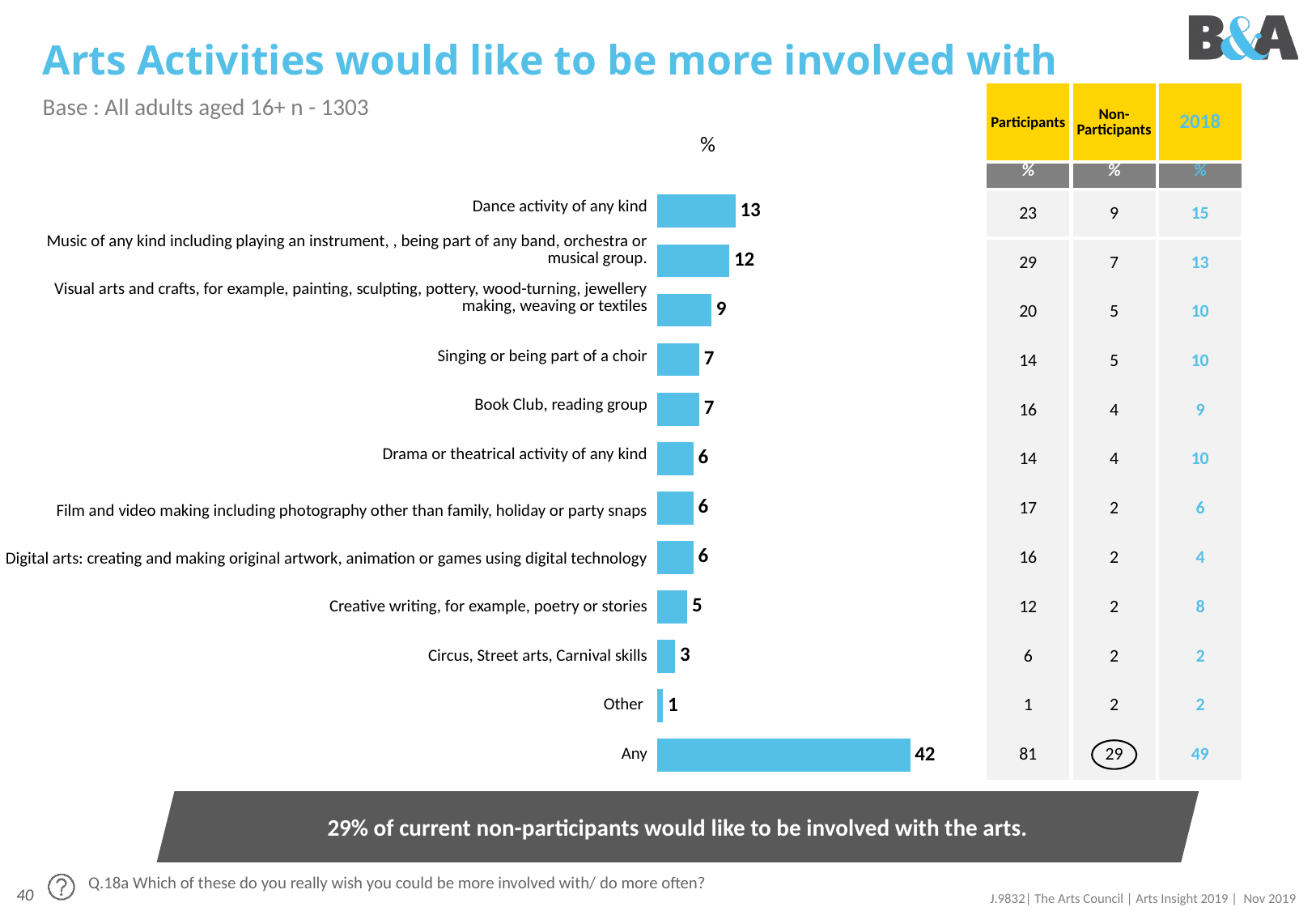
What is the value for Singing or being part of a choir? 7 Which category has the highest value in the bar chart? Any What is the title of the slide's chart? Arts Activities would like to be more involved with What is the value for Any? 42 What is the difference between the values for Any and Dance activity of any kind? 29 What is the value for Dance activity of any kind? 13 What is the difference between the values for Dance activity of any kind and Creative writing, for example, poetry or stories? 8 How many categories are shown in the bar chart? 12 Which is larger, the value for Visual arts and crafts or the value for Book Club, reading group? Visual arts and crafts What kind of chart is shown on the slide? Bar chart What is the value for Circus, Street arts, Carnival skills? 3 Which category has the lowest value in the bar chart? Other